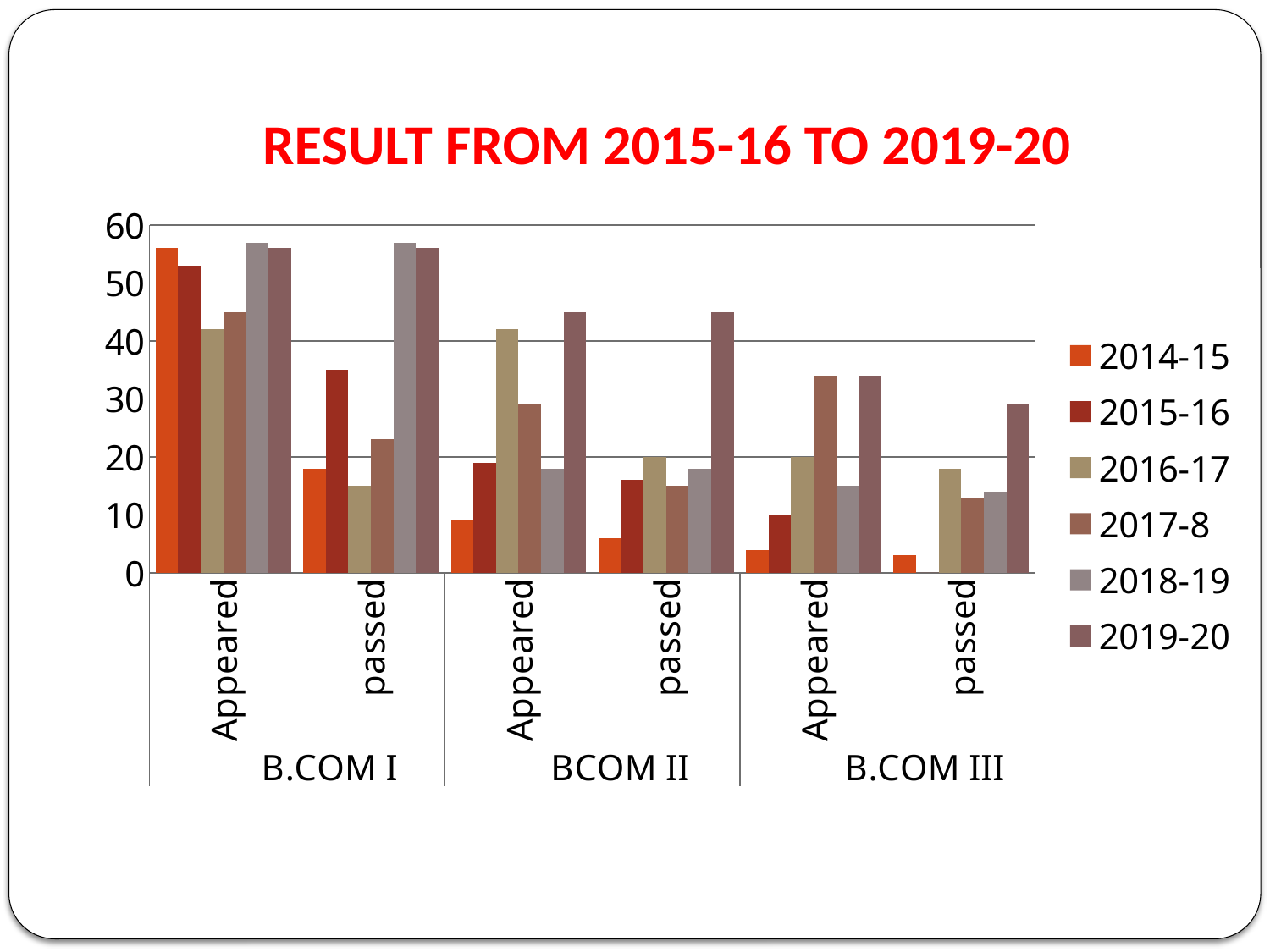
How many categories are shown along the x axis? 6 What is the title of the chart? RESULT FROM 2015-16 TO 2019-20 What colour represents the 2014-15 series in the legend? Orange Is the value for 2016-17 in B.COM I Appeared greater or less than 50? less Is the value for 2019-20 in BCOM II Appeared greater or less than 40? greater In B.COM I passed, which is larger: the value for 2014-15 or 2015-16? 2015-16 Which series has the highest value in BCOM II passed? 2019-20 How many series does the legend list? 6 Which series has the lowest value in B.COM III Appeared? 2014-15 What kind of chart is shown on the slide? Bar chart In B.COM III Appeared, which is larger: the value for 2016-17 or 2018-19? 2016-17